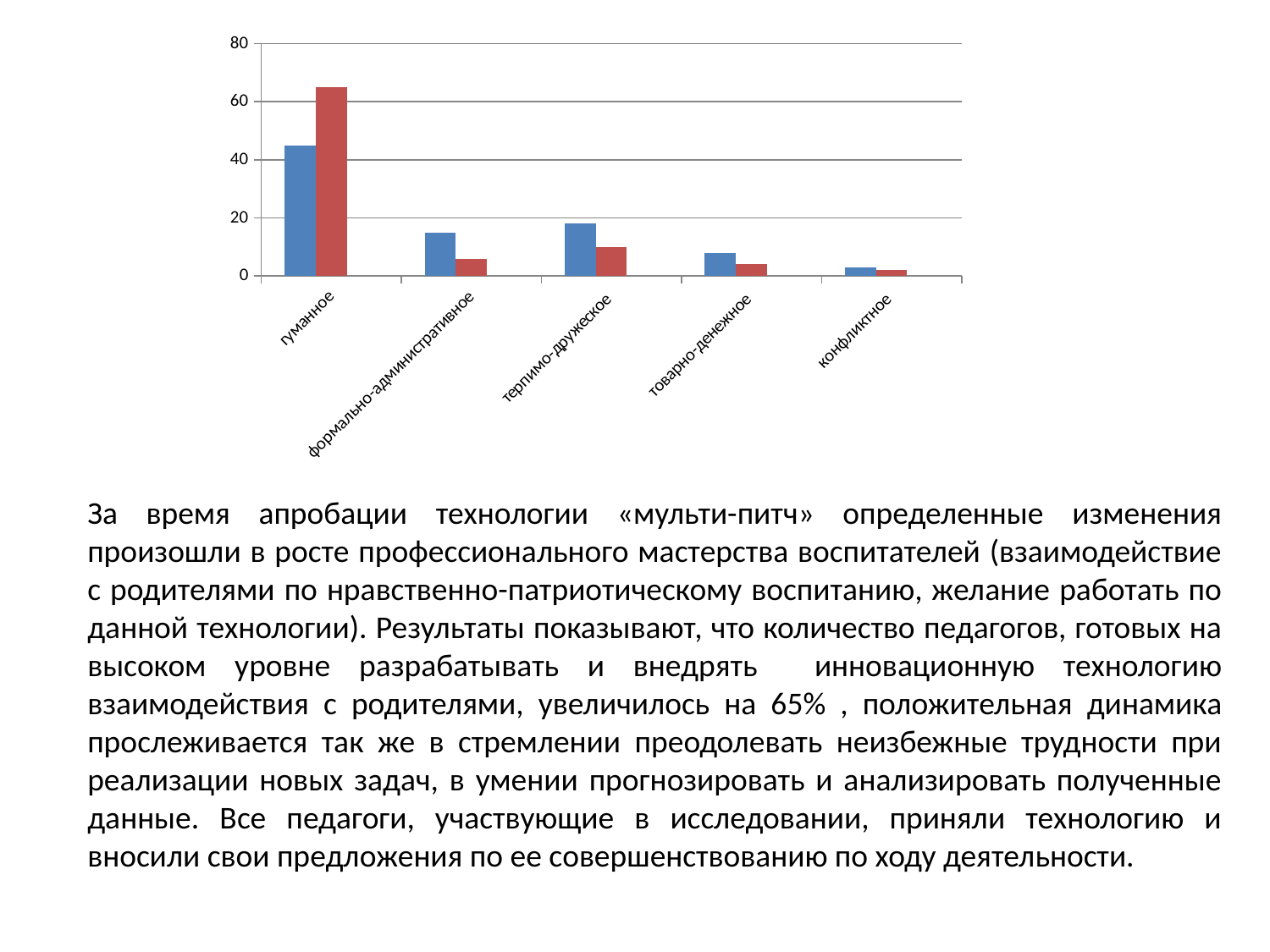
Which category has the tallest bars in the chart? гуманное Which category has the taller blue bar, терпимо-дружеское or конфликтное? терпимо-дружеское For the category формально-административное, which bar is taller, the blue one or the red one? the blue one How many categories are shown on the x axis of the chart? 5 For the category гуманное, which bar is taller, the blue one or the red one? the red one For the category формально-административное, is the blue bar greater or less than 20? less What is the highest value shown on the vertical axis of the chart? 80 For the category гуманное, is the blue bar greater or less than 60? less What kind of chart is shown on the slide? bar chart Which category has the shortest bars in the chart? конфликтное For the category гуманное, is the red bar greater or less than 60? greater